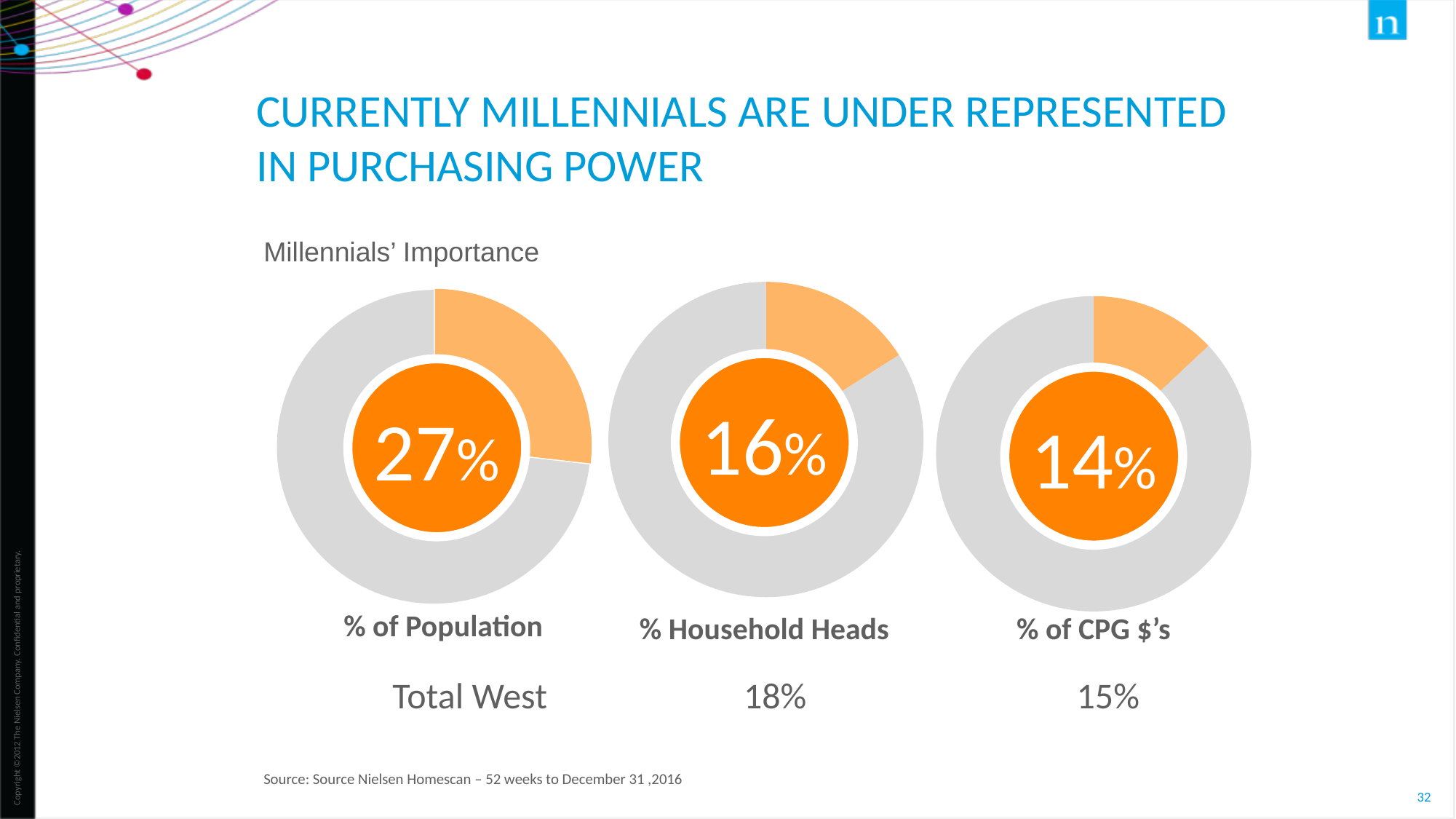
What is the heading above the three donut charts? Millennials' Importance What type of chart is used to show Millennials' Importance? Donut chart How many donut charts are shown on the slide? 3 Which is larger, the '% Household Heads' value or the '% of CPG $'s' value? % Household Heads What percentage is shown in the '% Household Heads' donut chart? 16% What is the Total West value shown under the '% Household Heads' chart? 18% What is the difference between the '% of Population' value and the '% of CPG $'s' value? 13% Which of the three donut charts shows the highest percentage? % of Population What percentage is shown in the '% of Population' donut chart? 27% What percentage is shown in the '% of CPG $'s' donut chart? 14% Which of the three donut charts shows the lowest percentage? % of CPG $'s What is the difference between the '% of Population' value and the '% Household Heads' value? 11%